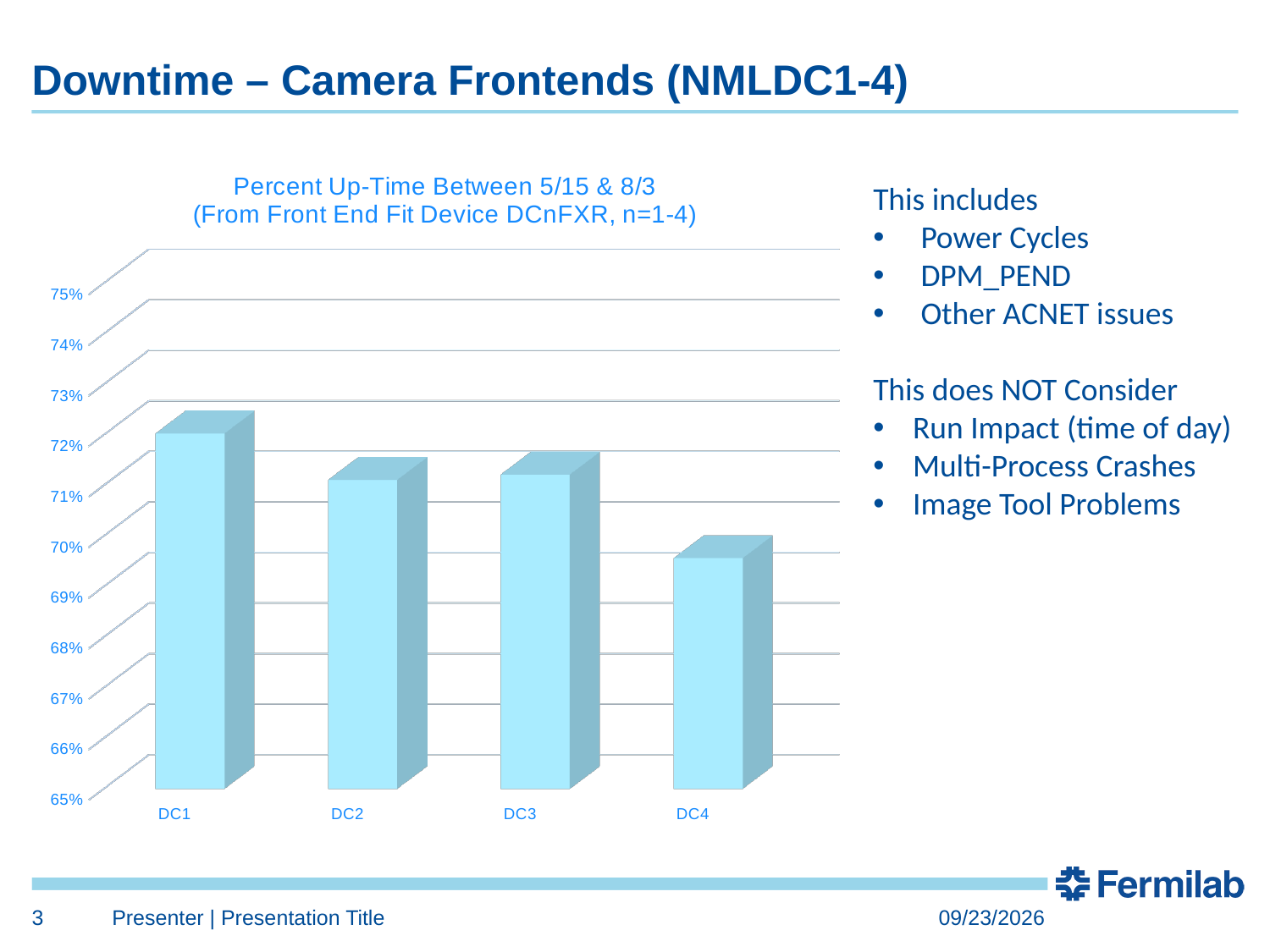
Is the value for DC4 greater or less than 71%? less What kind of chart is shown on the slide? bar chart Which category has the lowest percent up-time? DC4 How many categories are plotted on the x axis of the chart? 4 Is the value for DC2 greater or less than 70%? greater Is the value for DC1 greater or less than 71%? greater What is the lowest value shown on the chart's vertical axis? 65% Which category has the highest percent up-time? DC1 Which has a higher percent up-time, DC1 or DC4? DC1 Which has a higher percent up-time, DC1 or DC2? DC1 What is the title of the chart? Percent Up-Time Between 5/15 & 8/3 (From Front End Fit Device DCnFXR, n=1-4)